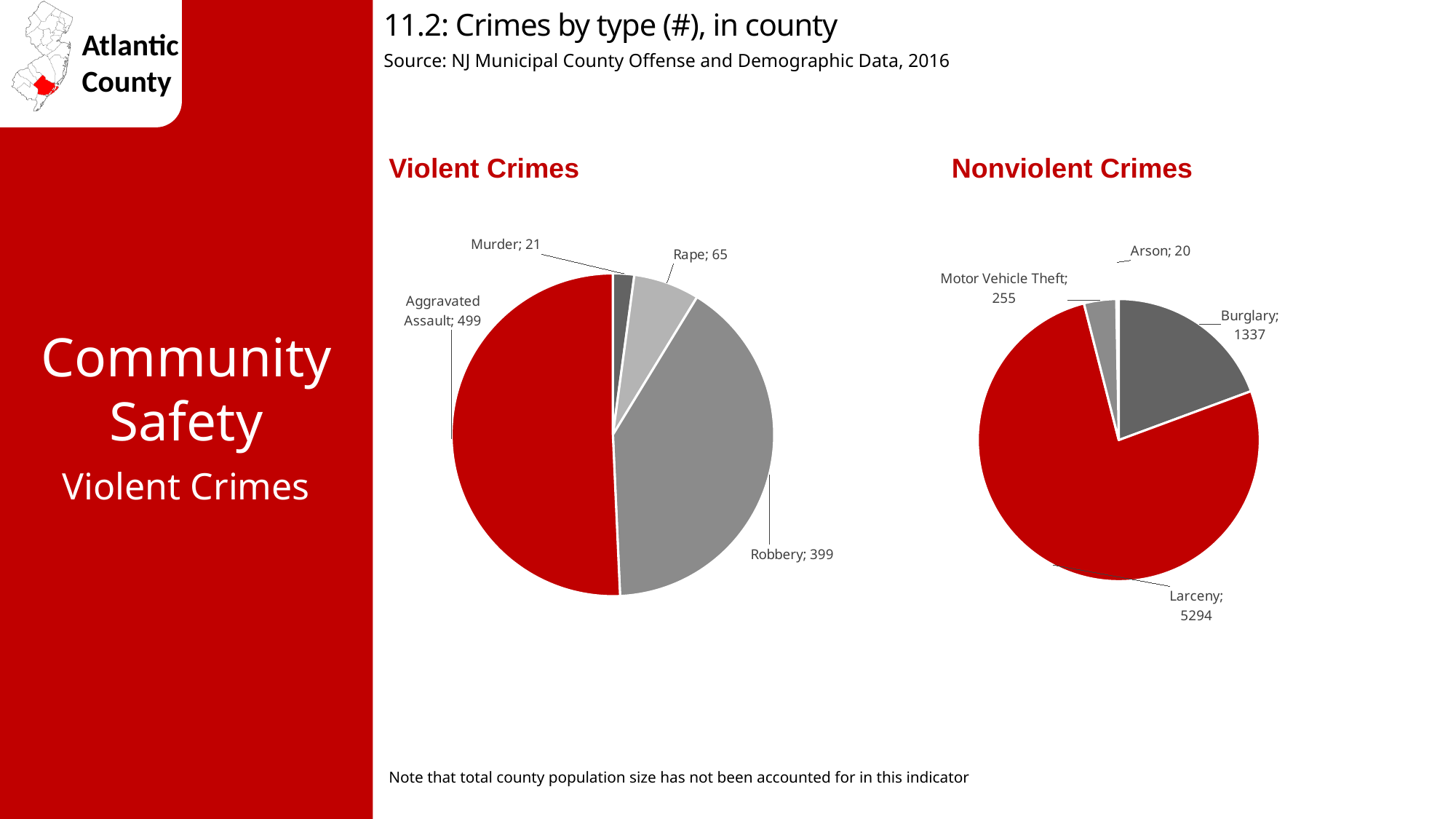
In the Violent Crimes chart, how many aggravated assaults are shown? 499 In the Nonviolent Crimes chart, what is the value for Motor Vehicle Theft? 255 What kind of chart is the Violent Crimes chart? Pie chart In the Violent Crimes chart, what is the difference between Aggravated Assault and Robbery? 100 In the Nonviolent Crimes chart, which crime type has the largest slice? Larceny In the Nonviolent Crimes chart, what is the difference between Larceny and Burglary? 3957 What is the total of all values in the Violent Crimes chart? 984 How many categories does the Nonviolent Crimes chart show? 4 In the Nonviolent Crimes chart, what is the value for Burglary? 1337 In the Violent Crimes chart, what is the value for Robbery? 399 In the Violent Crimes chart, which is larger, Rape or Murder? Rape In the Violent Crimes chart, which crime type has the smallest slice? Murder